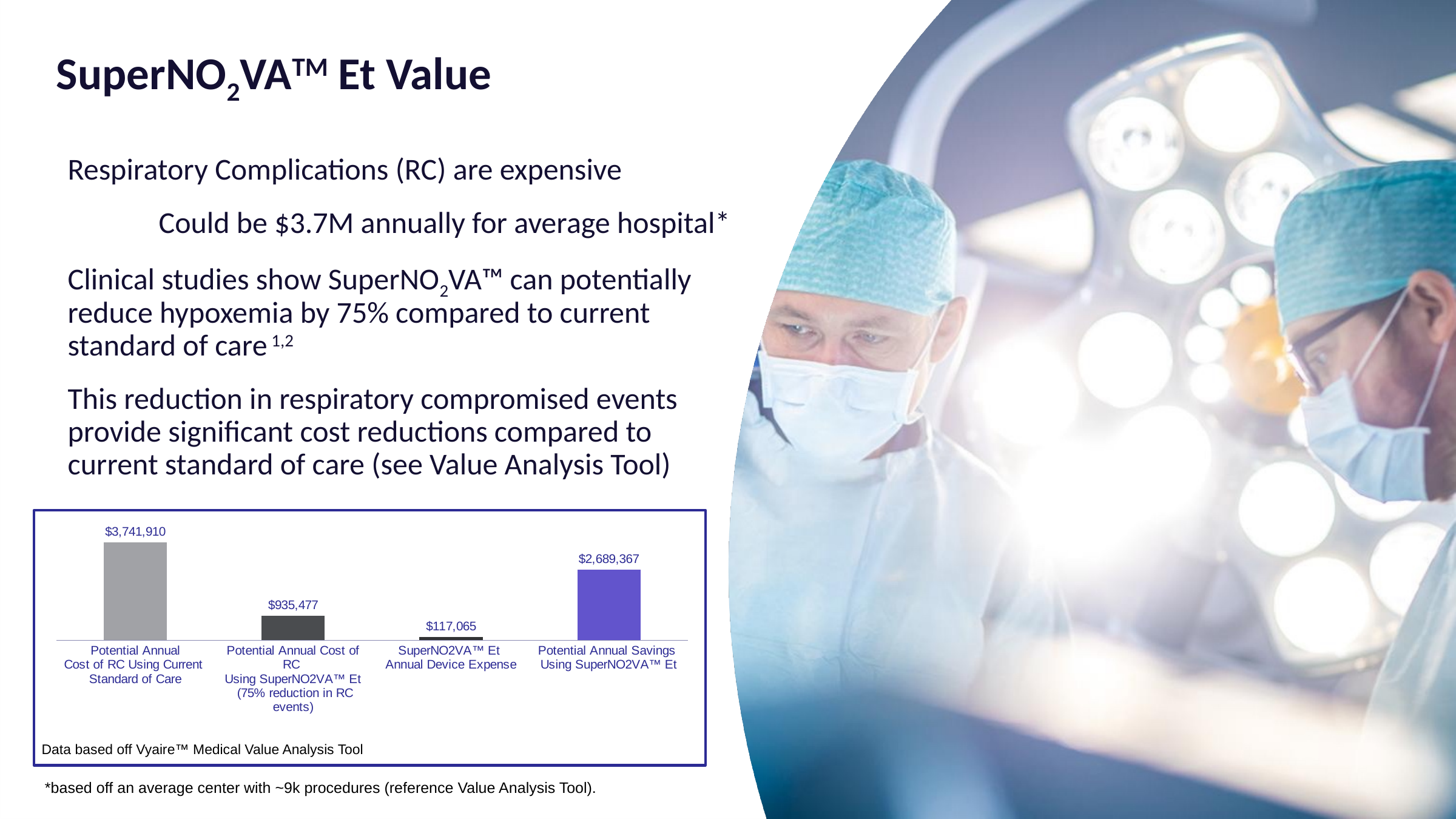
Which category has the highest value on the chart? Potential Annual Cost of RC Using Current Standard of Care What is the SuperNO2VA Et Annual Device Expense shown on the chart? $117,065 How many bars are shown on the chart? 4 What is the value for Potential Annual Cost of RC Using SuperNO2VA Et (75% reduction in RC events)? $935,477 What is the value for Potential Annual Savings Using SuperNO2VA Et? $2,689,367 What type of chart is shown on the slide? Bar chart What is the difference between the Potential Annual Cost of RC Using Current Standard of Care and the Potential Annual Cost of RC Using SuperNO2VA Et? $2,806,433 What is the difference between the Potential Annual Cost of RC Using Current Standard of Care and the Potential Annual Savings Using SuperNO2VA Et? $1,052,543 What is the value for Potential Annual Cost of RC Using Current Standard of Care? $3,741,910 Which is larger: the Potential Annual Savings Using SuperNO2VA Et or the Potential Annual Cost of RC Using SuperNO2VA Et? Potential Annual Savings Using SuperNO2VA Et Which category has the lowest value on the chart? SuperNO2VA Et Annual Device Expense According to the note inside the chart box, what is the data based off? Vyaire Medical Value Analysis Tool